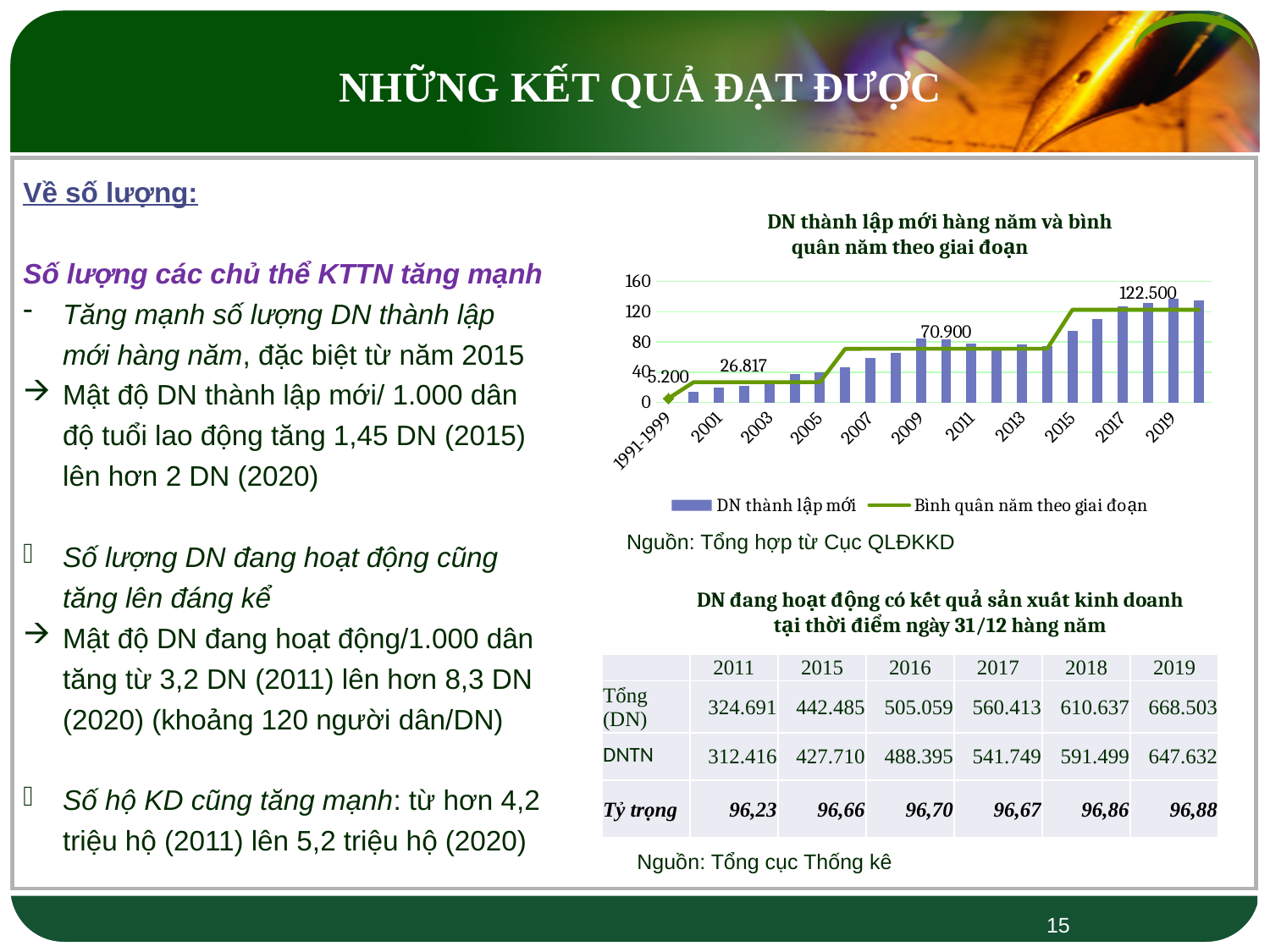
What is the labelled value of the 'Bình quân năm theo giai đoạn' line for the period that includes 2009? 70.900 What kind of chart is shown on the slide? A bar chart combined with a line How many series does the chart legend list? 2 Which is larger, the 'DN thành lập mới' bar for 2017 or for 2007? 2017 Is the 'DN thành lập mới' bar for 2019 greater or less than 120? greater What is the highest labelled value on the 'Bình quân năm theo giai đoạn' line? 122.500 Do the 'DN thành lập mới' bars generally rise or fall from left to right along the x axis? rise What is the labelled value of the 'Bình quân năm theo giai đoạn' line for the 1991-1999 period? 5.200 Is the 'DN thành lập mới' bar for 2001 greater or less than 40? less What is the title of the chart? DN thành lập mới hàng năm và bình quân năm theo giai đoạn What is the difference between the labelled line values 122.500 and 70.900? 51.600 What is the labelled value of the 'Bình quân năm theo giai đoạn' line for the period starting in 2000? 26.817